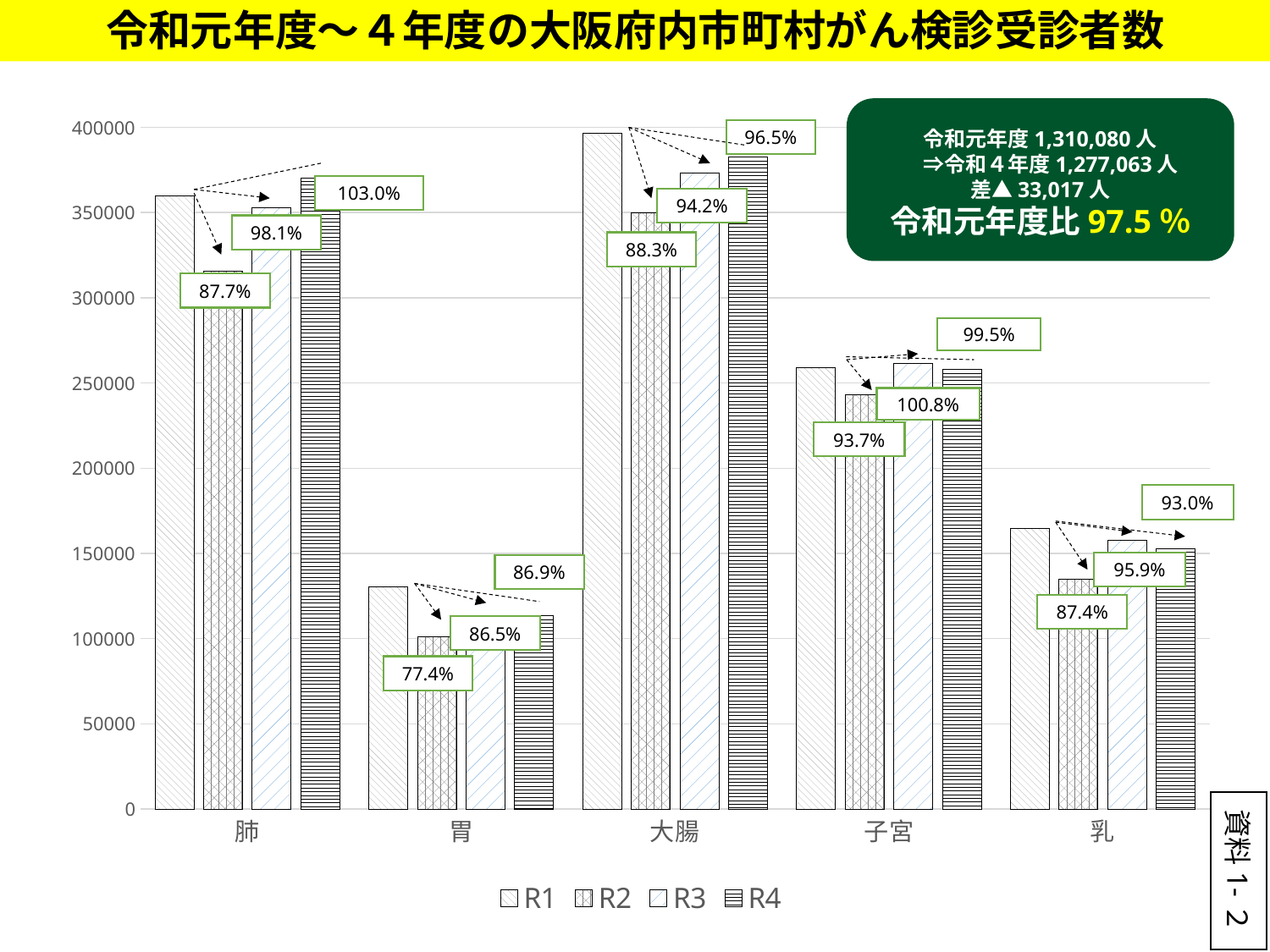
Is the R2 value for 乳 greater or less than 150000? less Which category has the highest number of screening participants? 大腸 What is the 令和元年度比 percentage shown in the green box? 97.5 % What percentage is shown in the label for R2 in the 胃 category? 77.4% How many series does the legend list? 4 Which is larger, the R1 value for 肺 or the R1 value for 乳? 肺 Is the R1 value for 大腸 greater or less than 400000? less Is the R1 value for 肺 greater or less than 350000? greater What percentage is shown in the label for R4 in the 肺 category? 103.0% Which category has the lowest number of screening participants? 胃 What kind of chart is shown on the slide? bar chart How many cancer screening categories are shown on the x axis? 5